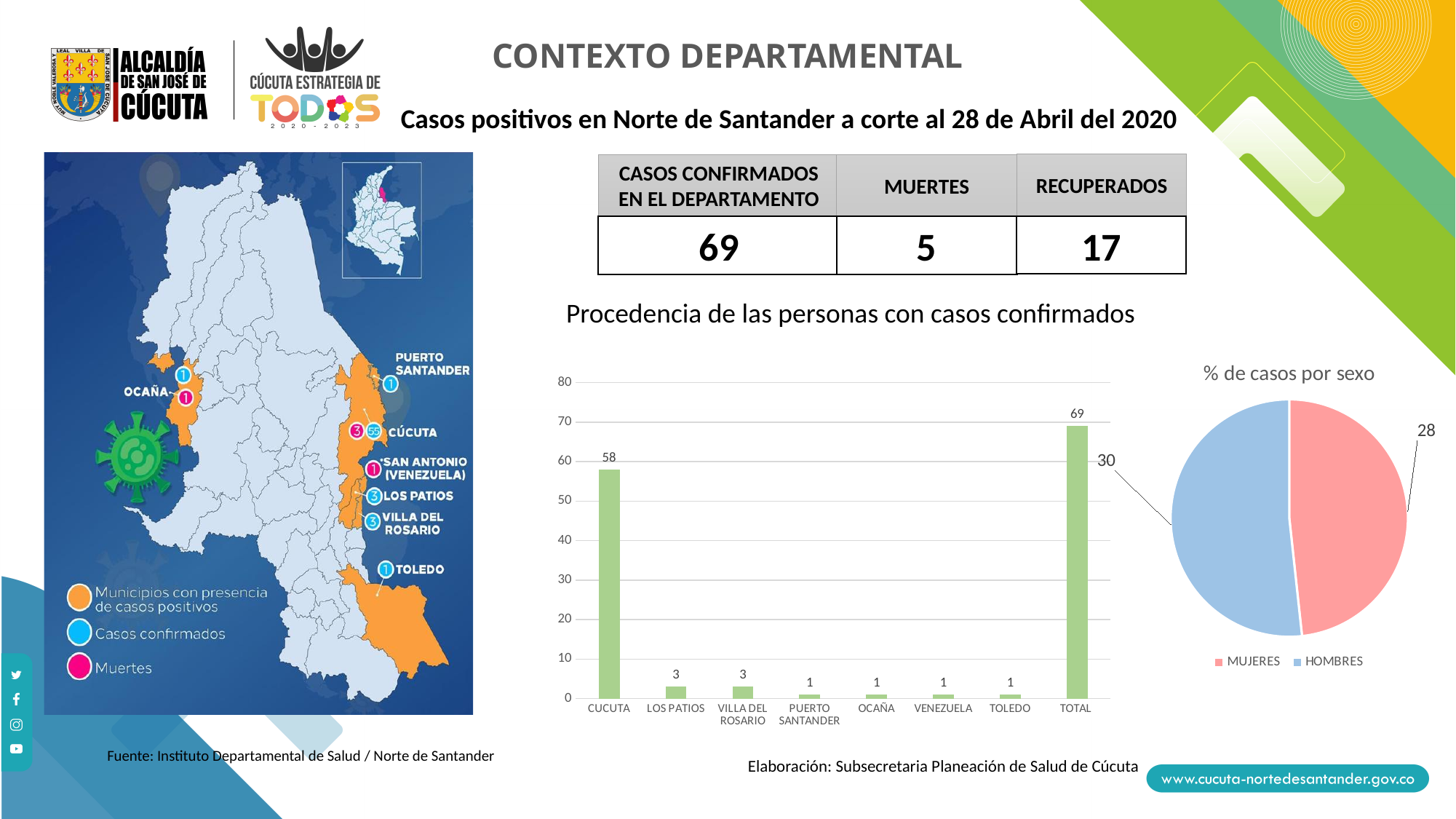
In the bar chart 'Procedencia de las personas con casos confirmados', what is the difference between the values for CUCUTA and VILLA DEL ROSARIO? 55 In the pie chart '% de casos por sexo', what is the value for HOMBRES? 30 In the bar chart 'Procedencia de las personas con casos confirmados', is the value for CUCUTA greater or less than 50? greater In the bar chart 'Procedencia de las personas con casos confirmados', which municipality (excluding TOTAL) has the highest value? CUCUTA In the bar chart 'Procedencia de las personas con casos confirmados', what is the value for TOTAL? 69 How many entries does the legend of the pie chart '% de casos por sexo' list? 2 What kind of chart is 'Procedencia de las personas con casos confirmados'? bar chart In the bar chart 'Procedencia de las personas con casos confirmados', which is larger, the value for LOS PATIOS or the value for TOLEDO? LOS PATIOS In the bar chart 'Procedencia de las personas con casos confirmados', what is the value for CUCUTA? 58 In the pie chart '% de casos por sexo', what is the value for MUJERES? 28 How many categories are shown on the x axis of the bar chart 'Procedencia de las personas con casos confirmados'? 8 In the bar chart 'Procedencia de las personas con casos confirmados', what is the value for LOS PATIOS? 3